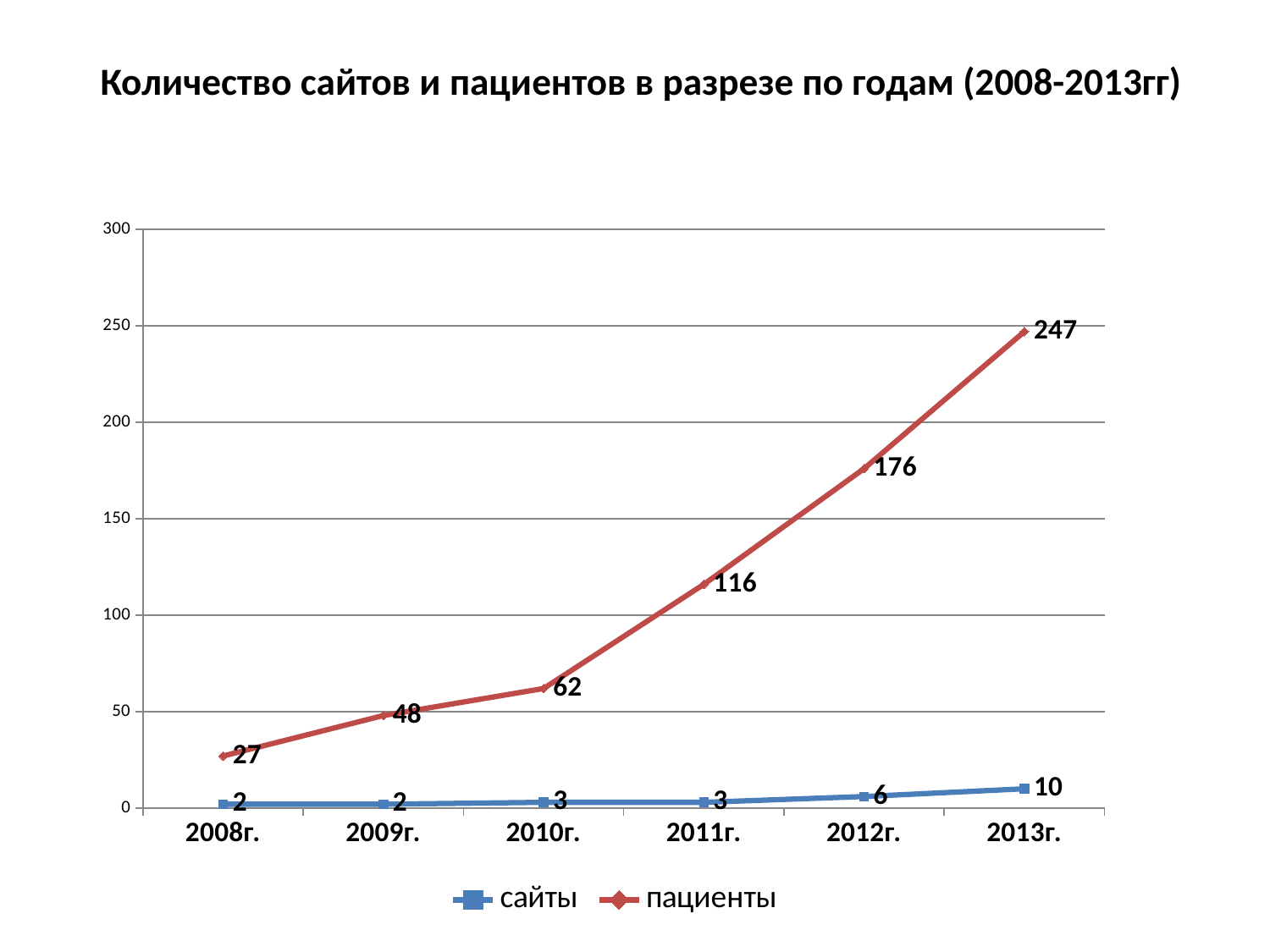
In which year is the value for пациенты lowest? 2008г. Do the values for пациенты rise or fall from 2008г. to 2013г.? rise Is the value for пациенты in 2012г. greater or less than 150? greater How many years are shown on the x axis? 6 What is the difference between the пациенты values for 2012г. and 2011г.? 60 How many series does the legend list? 2 What is the value for сайты in 2012г.? 6 In which year is the value for пациенты highest? 2013г. What is the value for пациенты in 2013г.? 247 Which is larger: the пациенты value for 2009г. or the сайты value for 2013г.? пациенты for 2009г. What kind of chart is shown on the slide? line chart What is the value for пациенты in 2010г.? 62